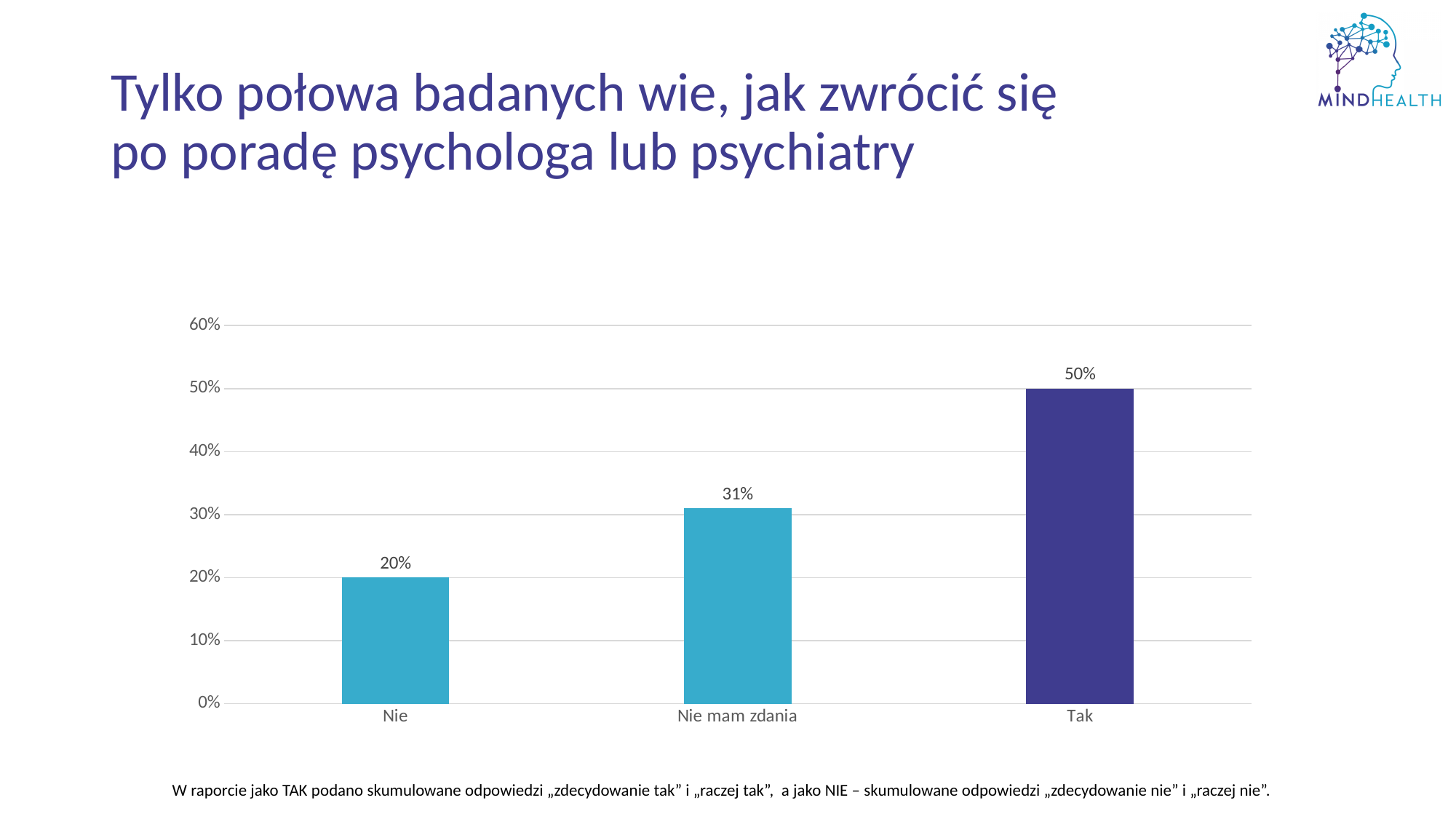
What is the value for "Nie mam zdania"? 31% What is the value for "Tak"? 50% Is the value for "Nie mam zdania" greater or less than 40%? less Which bar is coloured dark purple rather than light blue? Tak Which category has the lowest value? Nie What is the difference between the values for "Nie mam zdania" and "Nie"? 11% Which category has the highest value? Tak Which is larger, the value for "Nie mam zdania" or the value for "Nie"? Nie mam zdania What kind of chart is shown on the slide? bar chart How many categories are shown on the chart? 3 What is the value for "Nie"? 20% What is the difference between the values for "Tak" and "Nie"? 30%